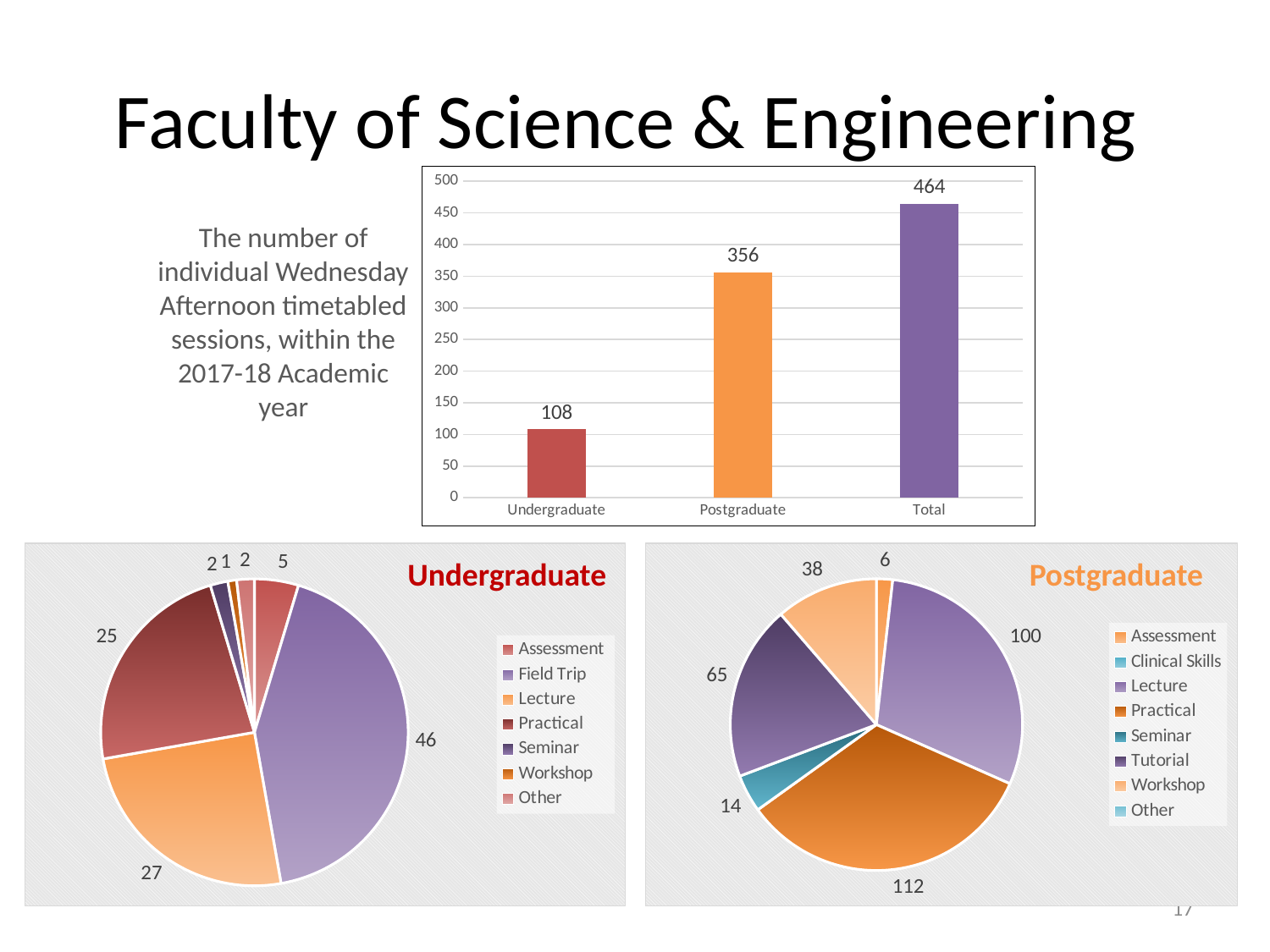
In the Postgraduate pie chart, which category has the largest slice? Practical In the bar chart at the top, how many categories are shown on the x axis? 3 In the Undergraduate pie chart, what is the value for Field Trip? 46 In the Undergraduate pie chart, which is larger, Lecture or Practical? Lecture In the bar chart at the top, what is the value for Undergraduate? 108 What kind of chart is the chart at the top of the slide? bar chart In the bar chart at the top, what is the value for Postgraduate? 356 In the Undergraduate pie chart, which category has the largest slice? Field Trip In the bar chart at the top, what is the difference between the Postgraduate and Undergraduate values? 248 In the Postgraduate pie chart, what is the value for Practical? 112 How many entries does the legend of the Postgraduate pie chart list? 8 In the Postgraduate pie chart, what is the value for Tutorial? 65